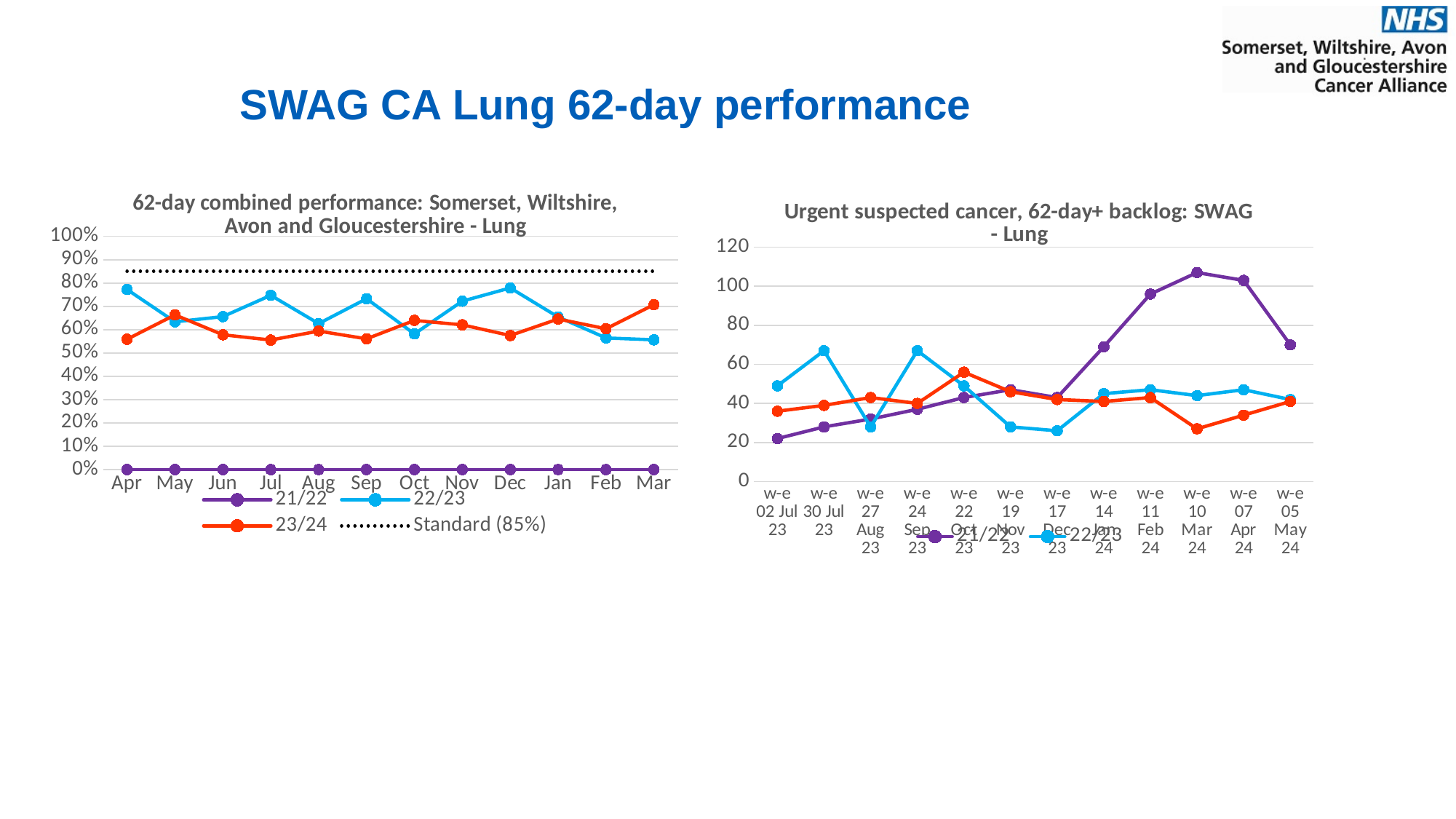
On the right chart (Urgent suspected cancer, 62-day+ backlog), how many series does the legend list? 2 On the left chart (62-day combined performance), is the 22/23 value for Apr greater or less than 70%? greater On the left chart (62-day combined performance), which series is higher in Mar, 22/23 or 23/24? 23/24 On the left chart (62-day combined performance), what value does the Standard line represent? 85% On the left chart (62-day combined performance), how many months are shown on the x axis? 12 On the left chart (62-day combined performance), what kind of chart is it? Line chart On the left chart (62-day combined performance), is the 23/24 value for Apr greater or less than 60%? less On the right chart (Urgent suspected cancer, 62-day+ backlog), is the 21/22 value for w-e 10 Mar 24 greater or less than 100? greater On the right chart (Urgent suspected cancer, 62-day+ backlog), does the 21/22 series rise or fall from w-e 02 Jul 23 to w-e 10 Mar 24? rise On the left chart (62-day combined performance), how many series does the legend list? 4 On the right chart (Urgent suspected cancer, 62-day+ backlog), at which week is the 21/22 series lowest? w-e 02 Jul 23 On the left chart (62-day combined performance), in which month is the 23/24 series highest? Mar